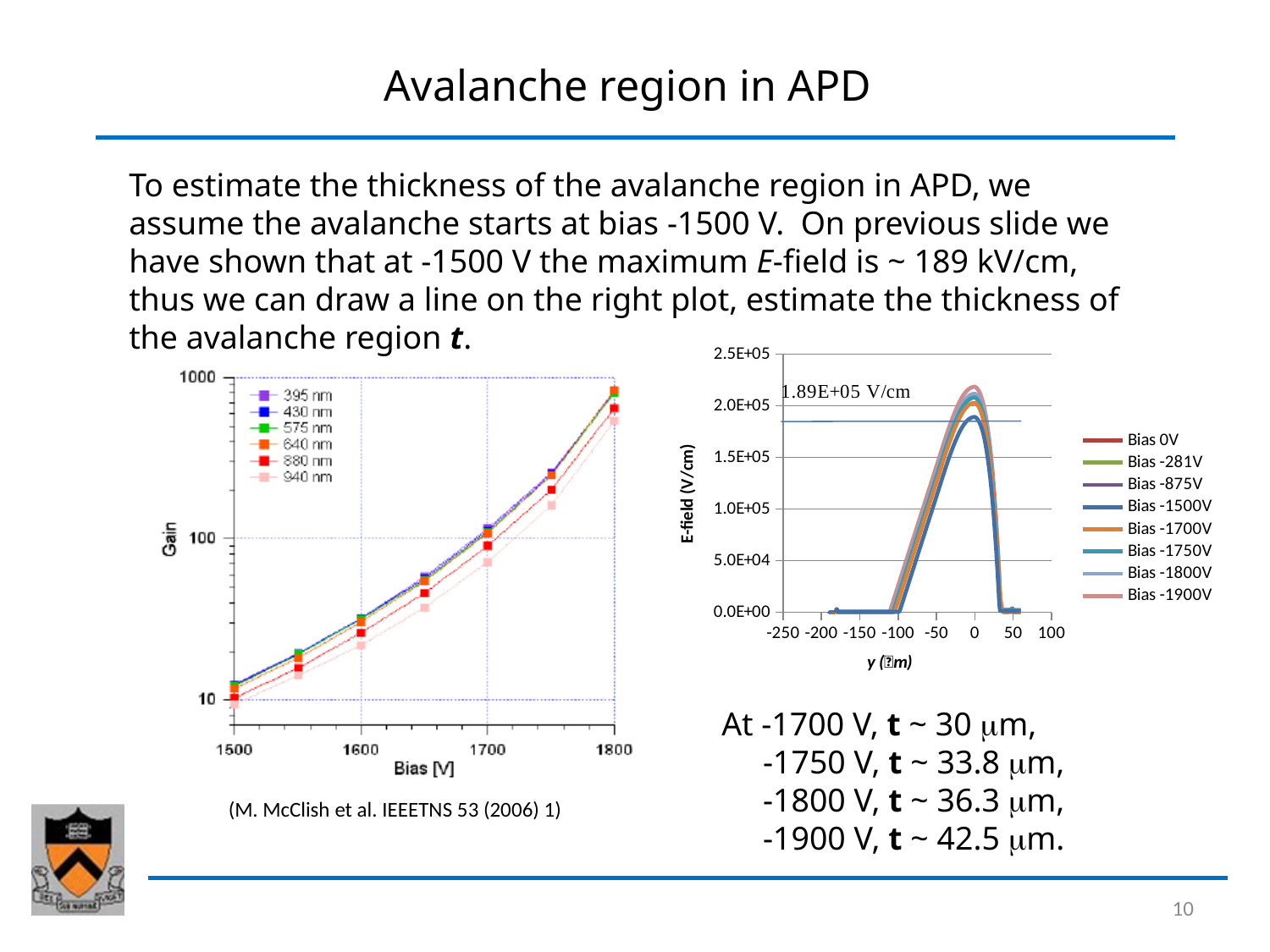
On the right-hand E-field chart, what E-field value is written next to the horizontal reference line? 1.89E+05 V/cm On the left-hand Gain vs Bias chart, which wavelength series has the lowest gain at 1500 V? 940 nm What kind of chart is the left-hand Gain vs Bias chart? line chart On the right-hand E-field chart, what is the label of the y axis? E-field (V/cm) On the left-hand Gain vs Bias chart, does the gain rise or fall as the bias increases from 1500 V to 1800 V? rises How many series does the legend of the left-hand Gain vs Bias chart list? 6 On the right-hand E-field chart, which bias series reaches the highest peak E-field? Bias -1900V On the right-hand E-field chart, is the peak E-field for Bias -1900V greater or less than 2.0E+05? greater How many series does the legend of the right-hand E-field chart list? 8 What kind of chart is the right-hand chart (E-field vs y)? line chart On the left-hand Gain vs Bias chart, is the gain for 395 nm at 1800 V greater or less than 100? greater On the right-hand E-field chart, is the peak E-field for Bias -1500V greater or less than 2.0E+05? less